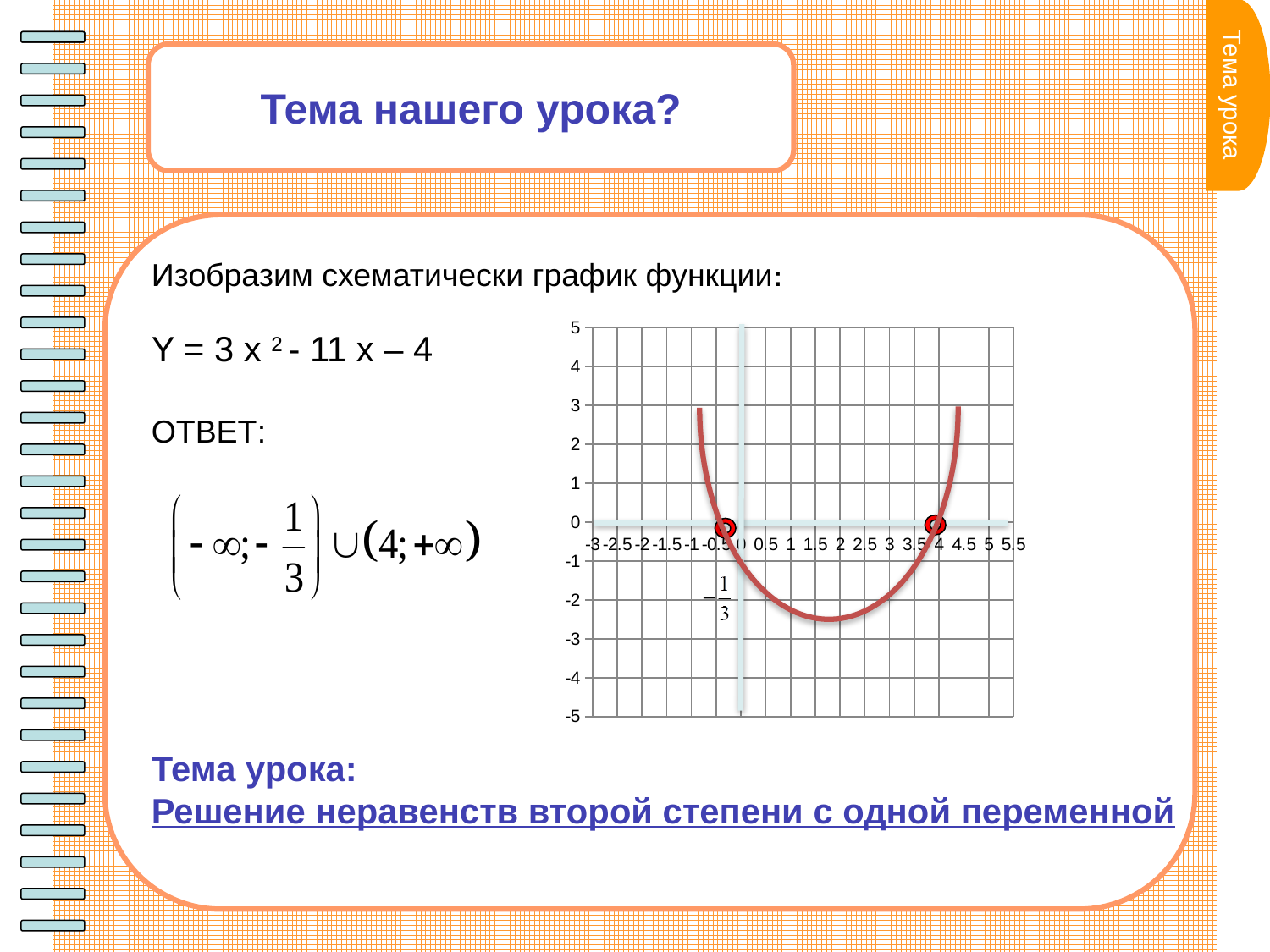
What kind of chart is shown on the slide? line chart How many points are marked with red circles on the curve? 2 Do the values of the curve rise or fall as x goes from 2.5 to 4.5? rise What is the highest value shown on the vertical axis? 5 Do the values of the curve rise or fall as x goes from -1 to 1.5? fall Is the value of the curve at x = 2 greater or less than 0? less What label is printed below the left-hand marked point on the curve? -1/3 At which x value is the right-hand marked point on the curve located? 4 What is the lowest value shown on the horizontal axis? -3